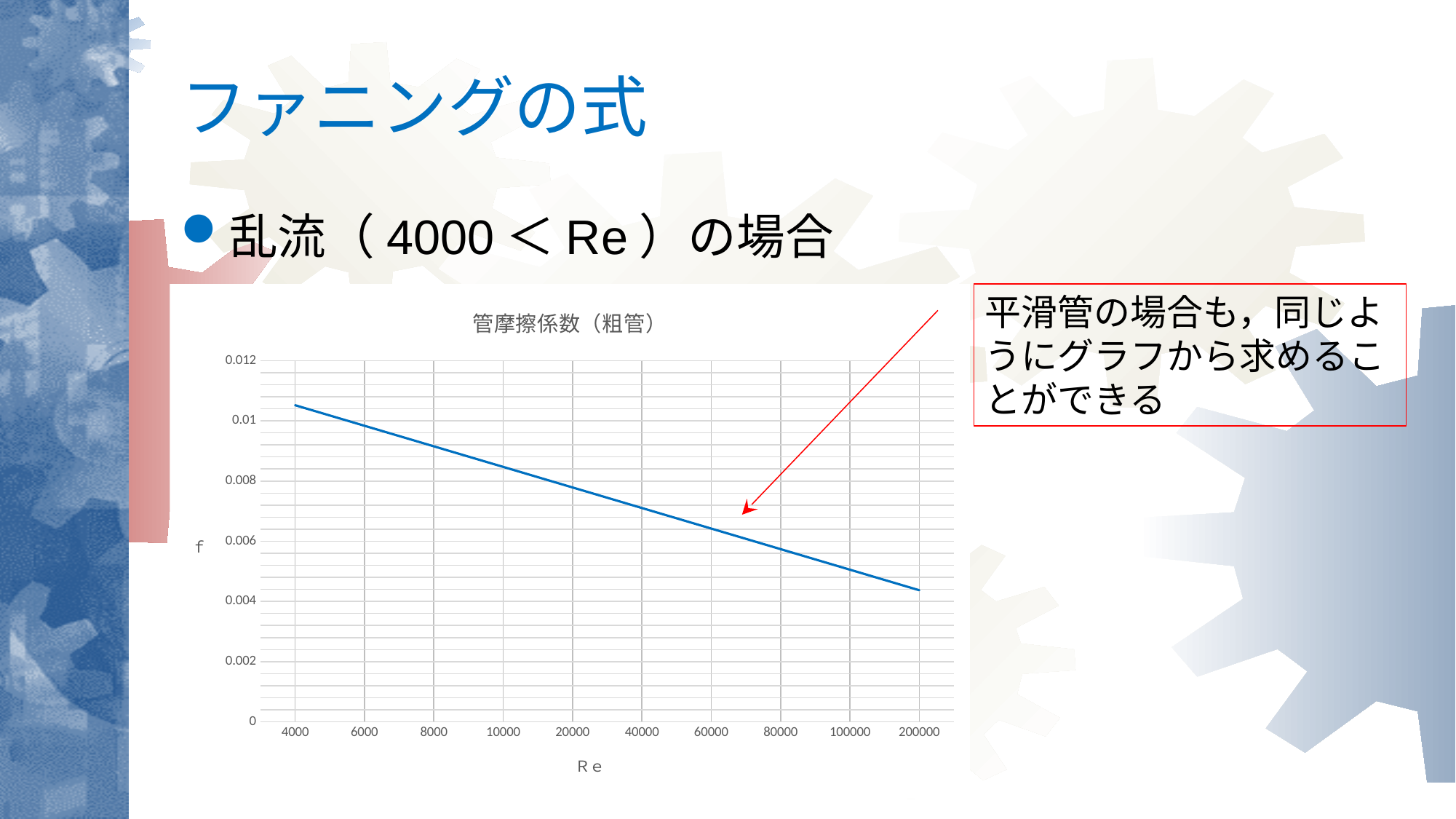
Is the value of f at Re = 200000 greater or less than 0.006? less How many Re values are marked along the x axis of the chart? 10 At which Re value is f lowest? 200000 What is the title of the chart? 管摩擦係数（粗管） What kind of chart is shown on the slide? line chart Do the values of f rise or fall as Re increases along the x axis? fall What is the label of the x axis of the chart? Re Which has the larger value of f: Re = 4000 or Re = 200000? Re = 4000 At which Re value is f highest? 4000 Is the value of f at Re = 20000 greater or less than 0.006? greater Is the value of f at Re = 100000 greater or less than 0.006? less